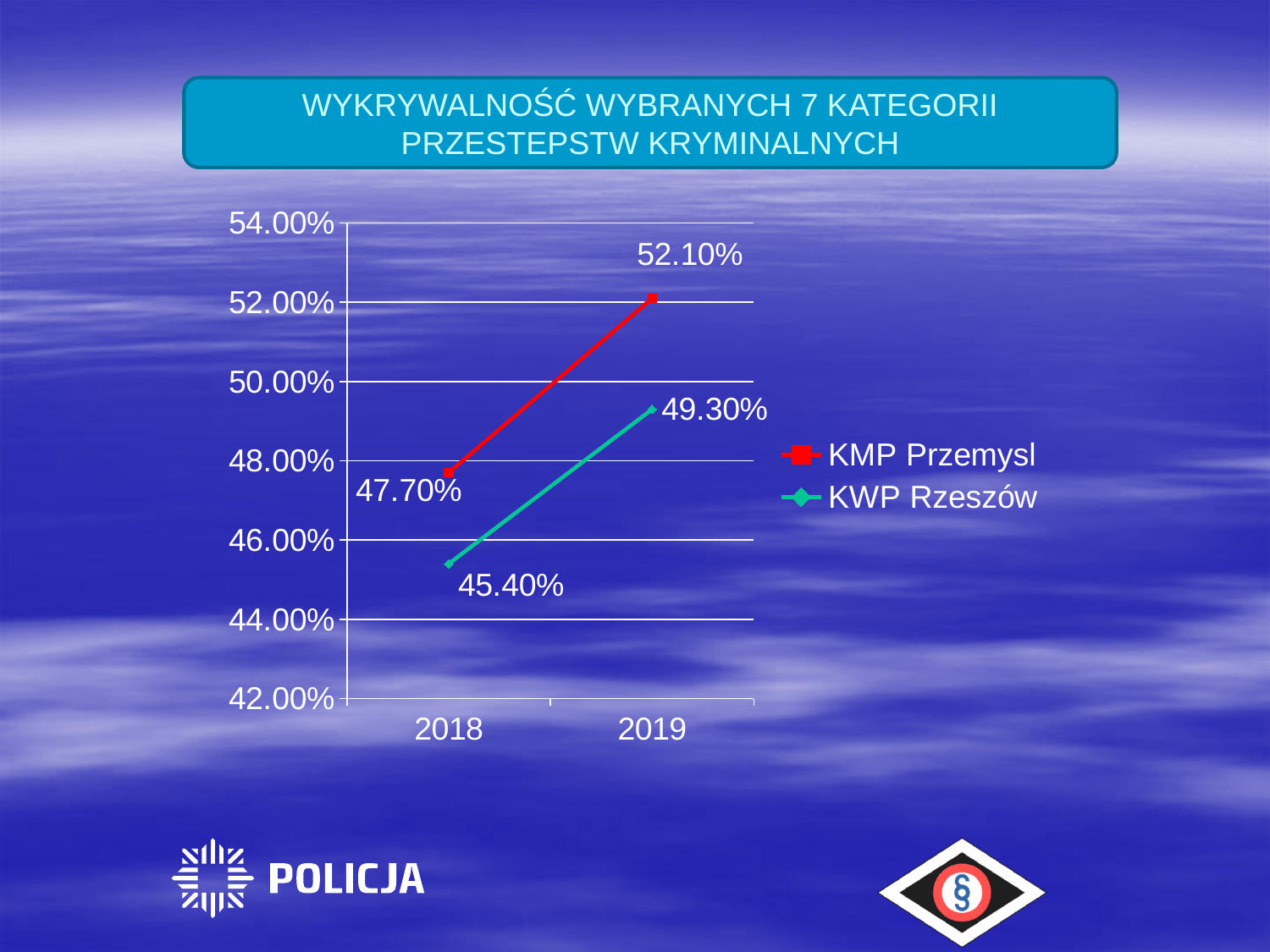
Does the value for KWP Rzeszów rise or fall from 2018 to 2019? rise What is the difference between KMP Przemysl and KWP Rzeszów in 2019? 2.80% Which series has the lower value in 2018? KWP Rzeszów What is the value for KWP Rzeszów in 2019? 49.30% What is the value for KMP Przemysl in 2019? 52.10% What kind of chart is shown on the slide? line chart What is the difference between the KMP Przemysl values in 2019 and 2018? 4.40% How many series does the legend list? 2 What is the value for KWP Rzeszów in 2018? 45.40% What is the value for KMP Przemysl in 2018? 47.70% How many years are shown on the x axis? 2 Which series has the higher value in 2019? KMP Przemysl